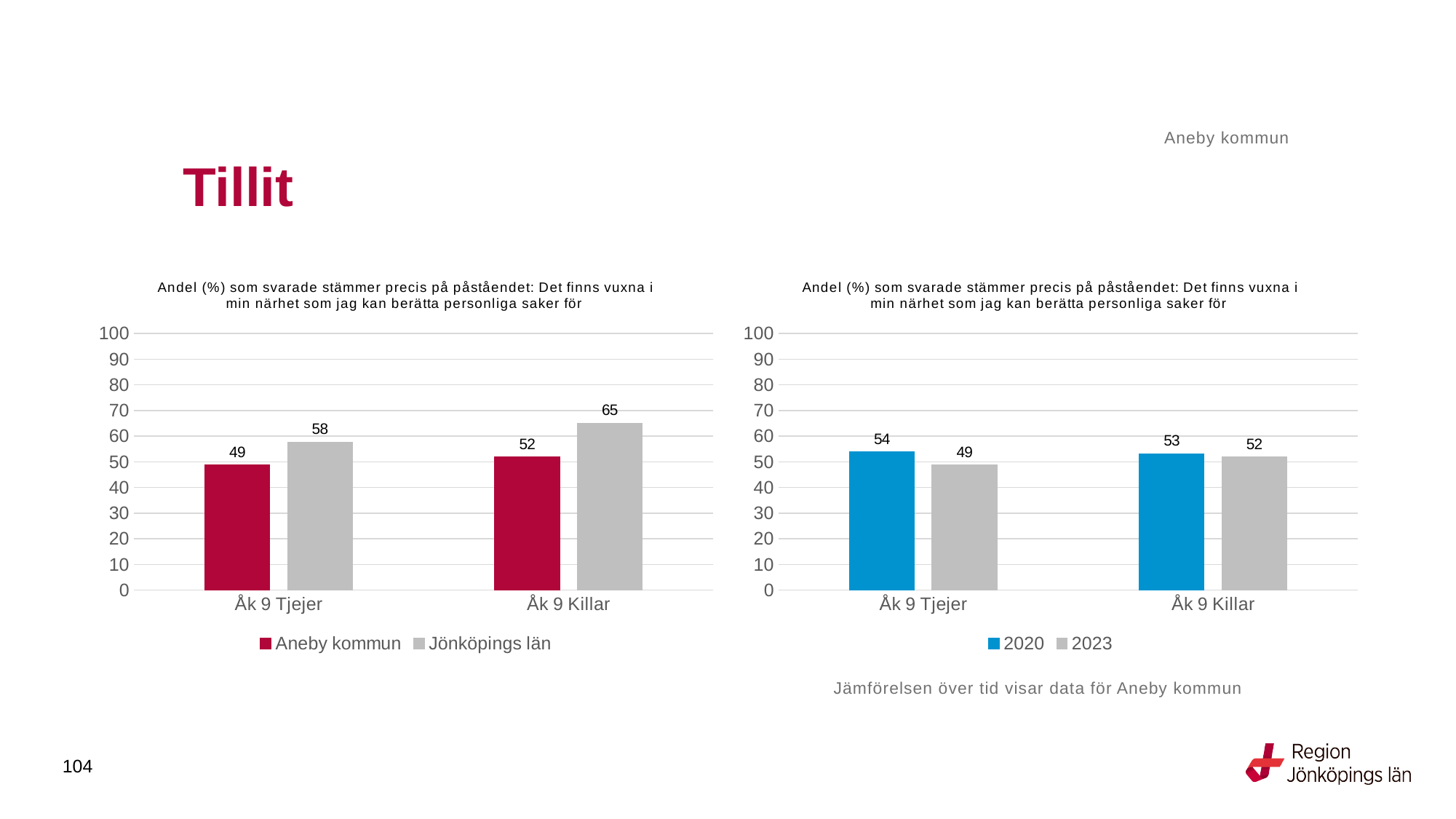
In the left chart, what is the difference between Jönköpings län and Aneby kommun for Åk 9 Killar? 13 How many series does the legend of the right chart list? 2 In the left chart, which bar is the highest? Jönköpings län, Åk 9 Killar In the left chart, which is larger for Åk 9 Tjejer: Aneby kommun or Jönköpings län? Jönköpings län In the right chart, which bar is the lowest? 2023, Åk 9 Tjejer What are the two legend entries of the left chart? Aneby kommun and Jönköpings län What kind of chart is the left chart? Bar chart In the left chart, what is the value for Aneby kommun for Åk 9 Tjejer? 49 In the right chart, what is the value for 2023 for Åk 9 Tjejer? 49 In the left chart, what is the value for Jönköpings län for Åk 9 Killar? 65 In the right chart, what is the value for 2020 for Åk 9 Killar? 53 In the right chart, what is the difference between 2020 and 2023 for Åk 9 Tjejer? 5